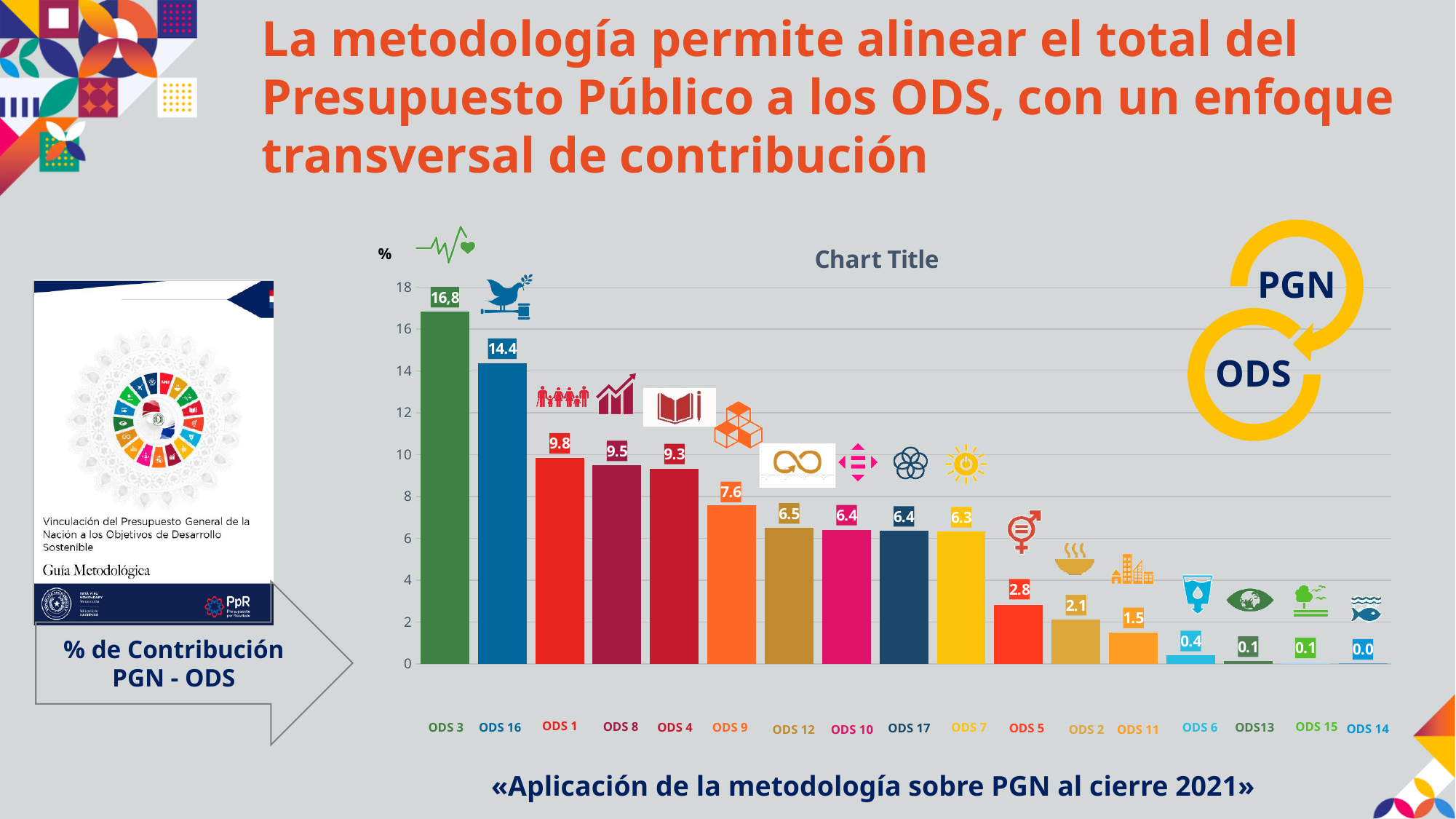
What is the value for ODS 11? 1.5 What is the value for ODS 3? 16,8 What kind of chart is shown? Bar chart How many ODS categories are shown on the x axis? 17 What is the value for ODS 9? 7.6 What is the difference between the values for ODS 16 and ODS 1? 4.6 Which is larger, the value for ODS 8 or the value for ODS 4? ODS 8 Which ODS has the lowest value? ODS 14 What is the value for ODS 16? 14.4 Which ODS has the highest value? ODS 3 Do the values rise or fall from left to right along the x axis? Fall What is the difference between the values for ODS 5 and ODS 2? 0.7